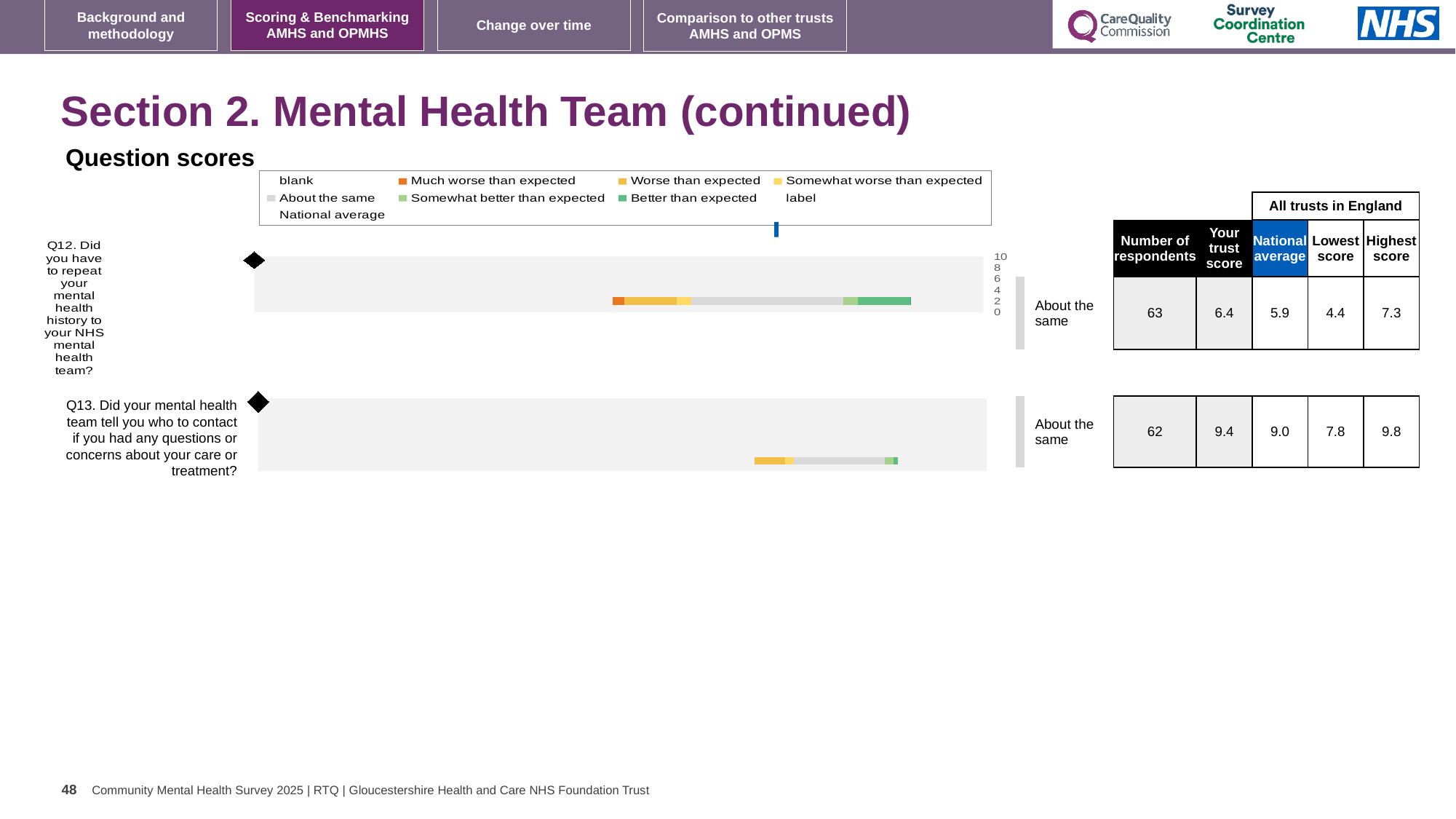
What kind of chart is used to show the question scores for Q12 and Q13? bar chart For the Q13 chart, how many respondents answered the question? 62 For the Q12 chart, what is the difference between the highest score (7.3) and the lowest score (4.4)? 2.9 How many questions (Q12 and Q13) have score charts on this slide? 2 For the Q12 chart, what benchmark category is the trust's score placed in? About the same What is the maximum value shown on the score axis of the Q12 chart? 10 For the Q13 chart (who to contact with questions or concerns), what is the trust's score? 9.4 For the Q13 chart, what is the highest score among all trusts in England? 9.8 For the Q13 chart, is the trust's score or the national average larger? Trust score (9.4) For the Q12 chart (repeating your mental health history), what is the trust's score shown in the table? 6.4 For the Q12 chart, what is the lowest score among all trusts in England? 4.4 For the Q12 chart, what is the national average score? 5.9